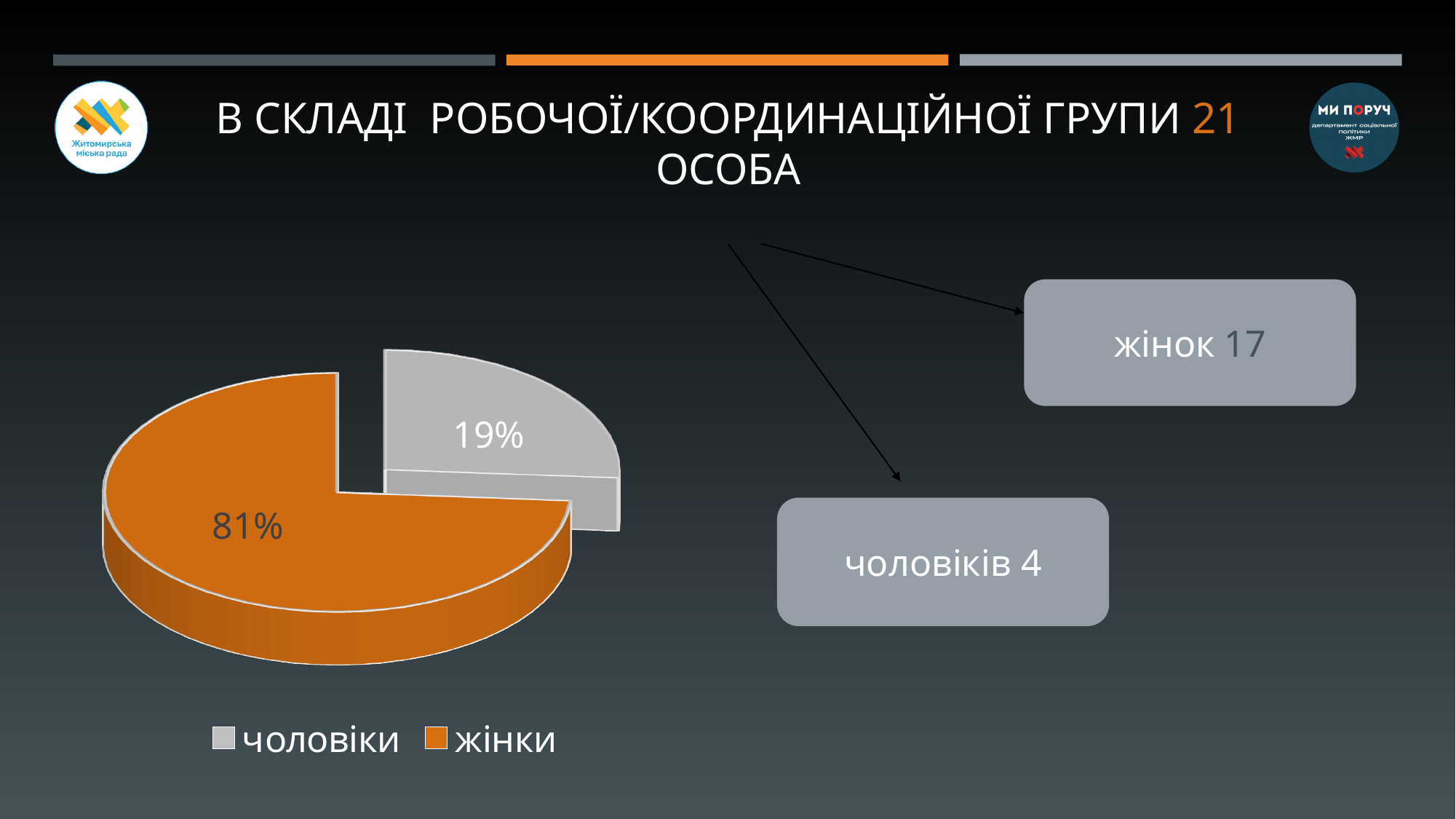
What colour is the жінки slice in the pie chart? orange What percentage of the pie chart is labelled for жінки? 81% Which category has the largest slice of the pie chart? жінки What percentage of the pie chart is labelled for чоловіки? 19% Which category has the smallest slice of the pie chart? чоловіки What is the difference in percentage points between the жінки slice and the чоловіки slice? 62 What colour is the чоловіки slice in the pie chart? grey How many slices does the pie chart have? 2 Which slice is larger, жінки or чоловіки? жінки How many entries does the legend list? 2 What kind of chart is shown on the slide? pie chart What share of the pie does the чоловіки slice represent? 19%